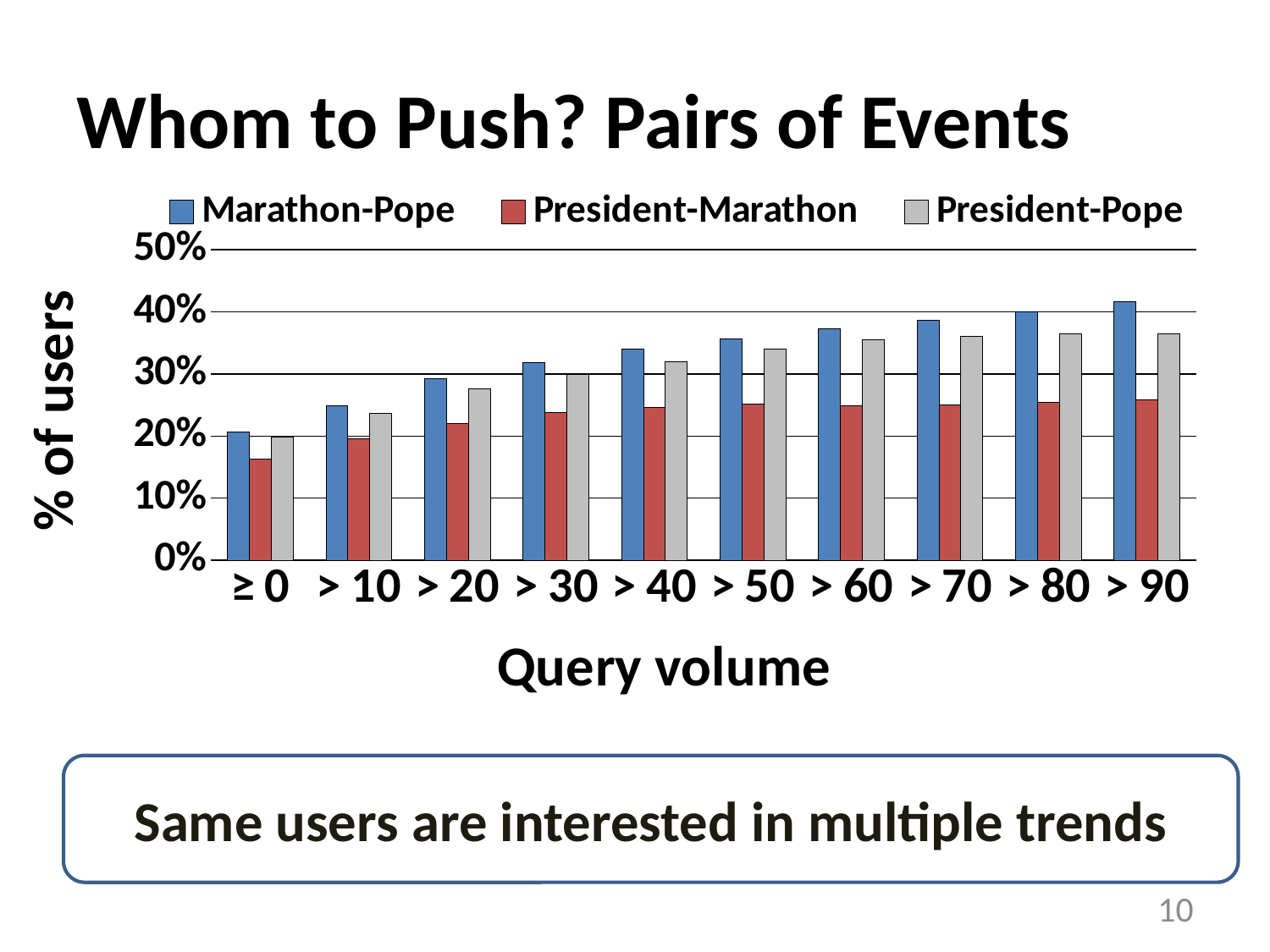
How many query volume categories are shown on the x axis? 10 Is the value for President-Pope at > 90 greater or less than 30%? greater What kind of chart is shown on the slide? bar chart What is the title of the y axis? % of users Which series has the lowest bar in the ≥ 0 query volume category? President-Marathon At > 40 query volume, which is larger: Marathon-Pope or President-Marathon? Marathon-Pope Is the value for Marathon-Pope at > 80 greater or less than 30%? greater Is the value for President-Marathon at > 50 greater or less than 30%? less Do the Marathon-Pope values rise or fall as query volume increases along the x axis? rise How many series does the legend list? 3 Which series has the highest bar in the > 90 query volume category? Marathon-Pope